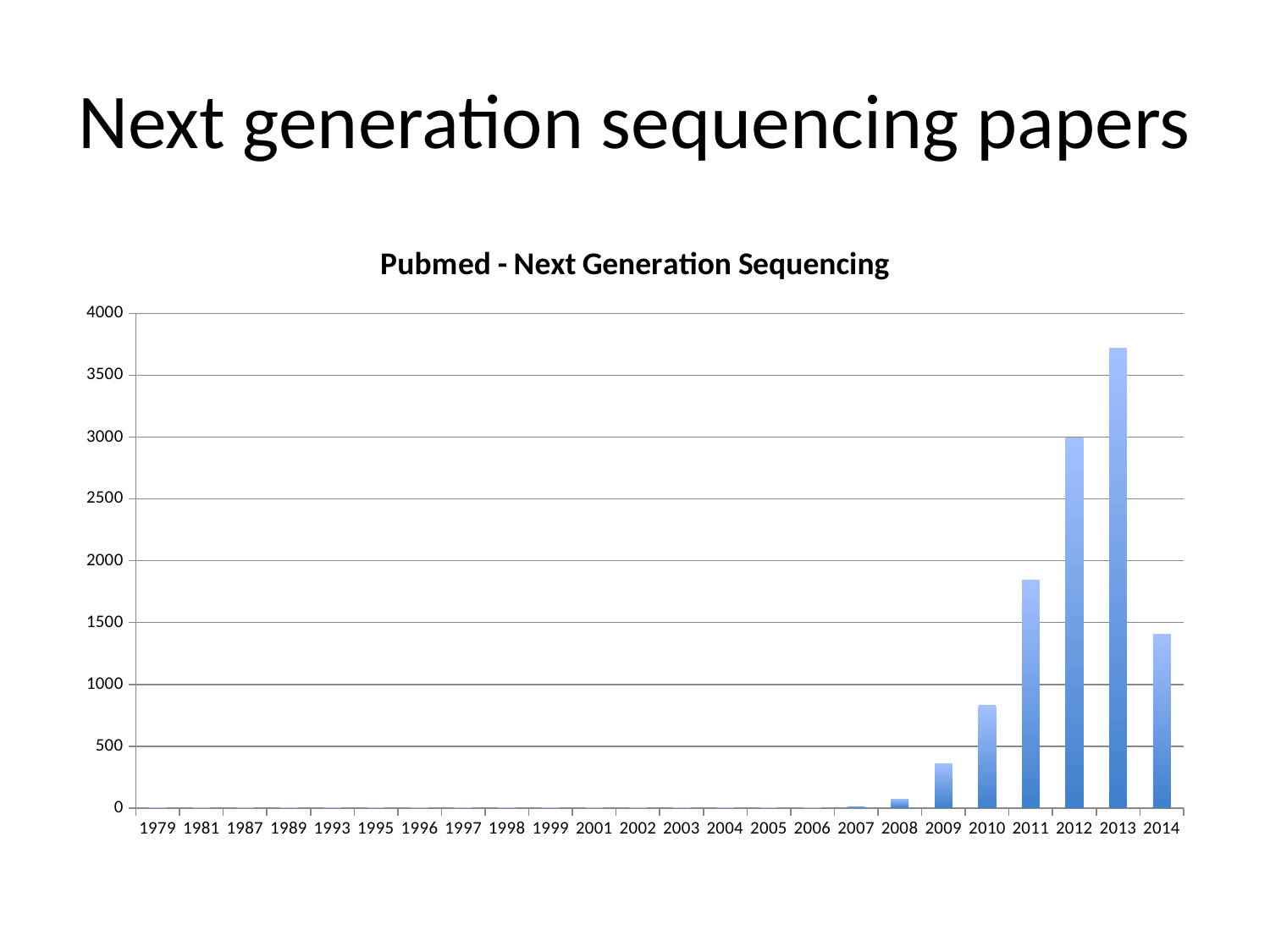
Is the value for 2011 greater or less than 2000? less Is the value for 2010 greater or less than 500? greater Do the values rise or fall from 2008 to 2013? rise Which year has the highest number of papers? 2013 Is the value for 2014 greater or less than 1000? greater Which is larger, the value for 2010 or the value for 2011? 2011 How many years are shown on the x axis? 24 What is the title of the chart? Pubmed - Next Generation Sequencing Which is larger, the value for 2012 or the value for 2014? 2012 What kind of chart is shown on the slide? bar chart